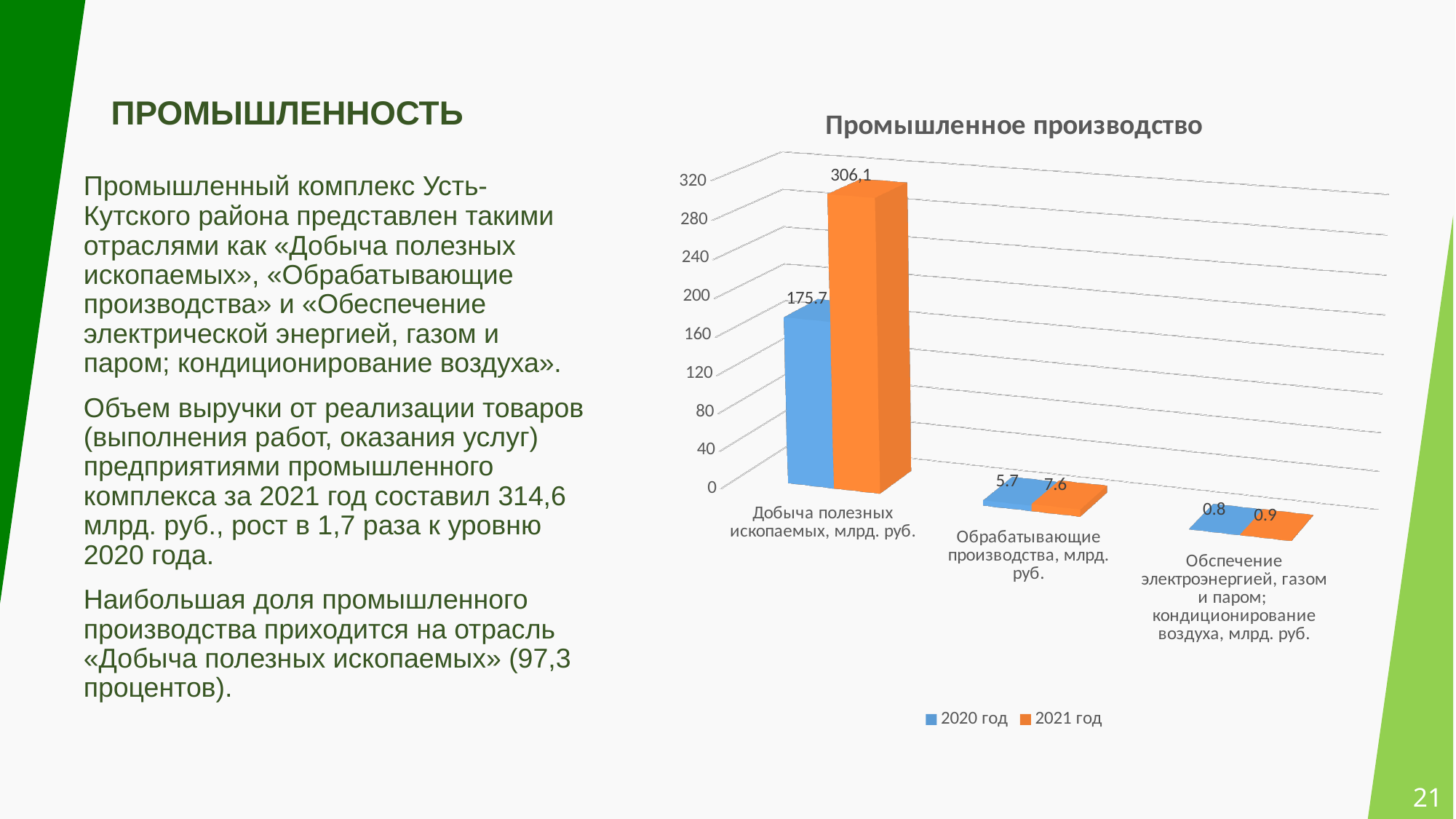
What is the value for 2020 год in the Обеспечение электроэнергией, газом и паром category? 0.8 Which category has the highest value for 2021 год? Добыча полезных ископаемых, млрд. руб. What is the value for 2021 год in the Добыча полезных ископаемых category? 306,1 What is the value for 2020 год in the Добыча полезных ископаемых category? 175,7 What type of chart is shown on the slide? Bar chart Which is larger for Обрабатывающие производства: the 2020 год value or the 2021 год value? 2021 год What is the value for 2020 год in the Обрабатывающие производства category? 5.7 What is the value for 2021 год in the Обрабатывающие производства category? 7.6 How many series does the legend list? 2 Which category has the lowest value for 2020 год? Обеспечение электроэнергией, газом и паром; кондиционирование воздуха, млрд. руб. How many categories are shown on the x axis? 3 What is the difference between the 2021 год and 2020 год values for Добыча полезных ископаемых? 130,4